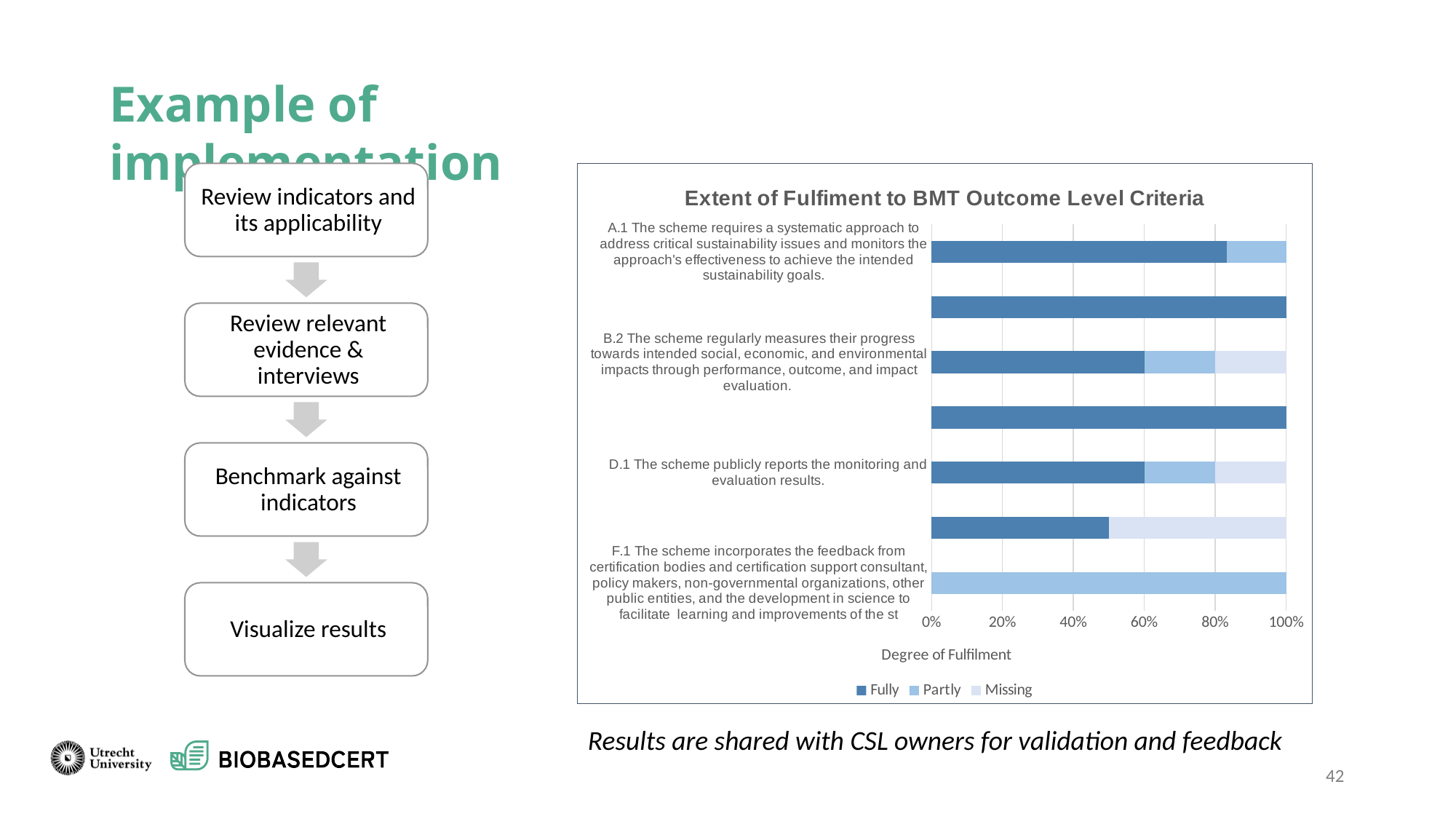
Which of the labelled criteria has the lowest Fully share? F.1 Which has a larger Fully share, criterion A.1 or criterion D.1? A.1 How many bars are plotted in the chart? 7 Is the Fully value for criterion D.1 greater or less than 80%? less What are the three series named in the chart legend? Fully, Partly, Missing What kind of chart is shown on the slide? Stacked bar chart Is the Partly value for criterion F.1 greater or less than 80%? greater What is the title of the chart? Extent of Fulfiment to BMT Outcome Level Criteria Is the Missing value for criterion B.2 greater or less than 40%? less Which series makes up the entire bar for criterion F.1? Partly How many series does the legend of the chart list? 3